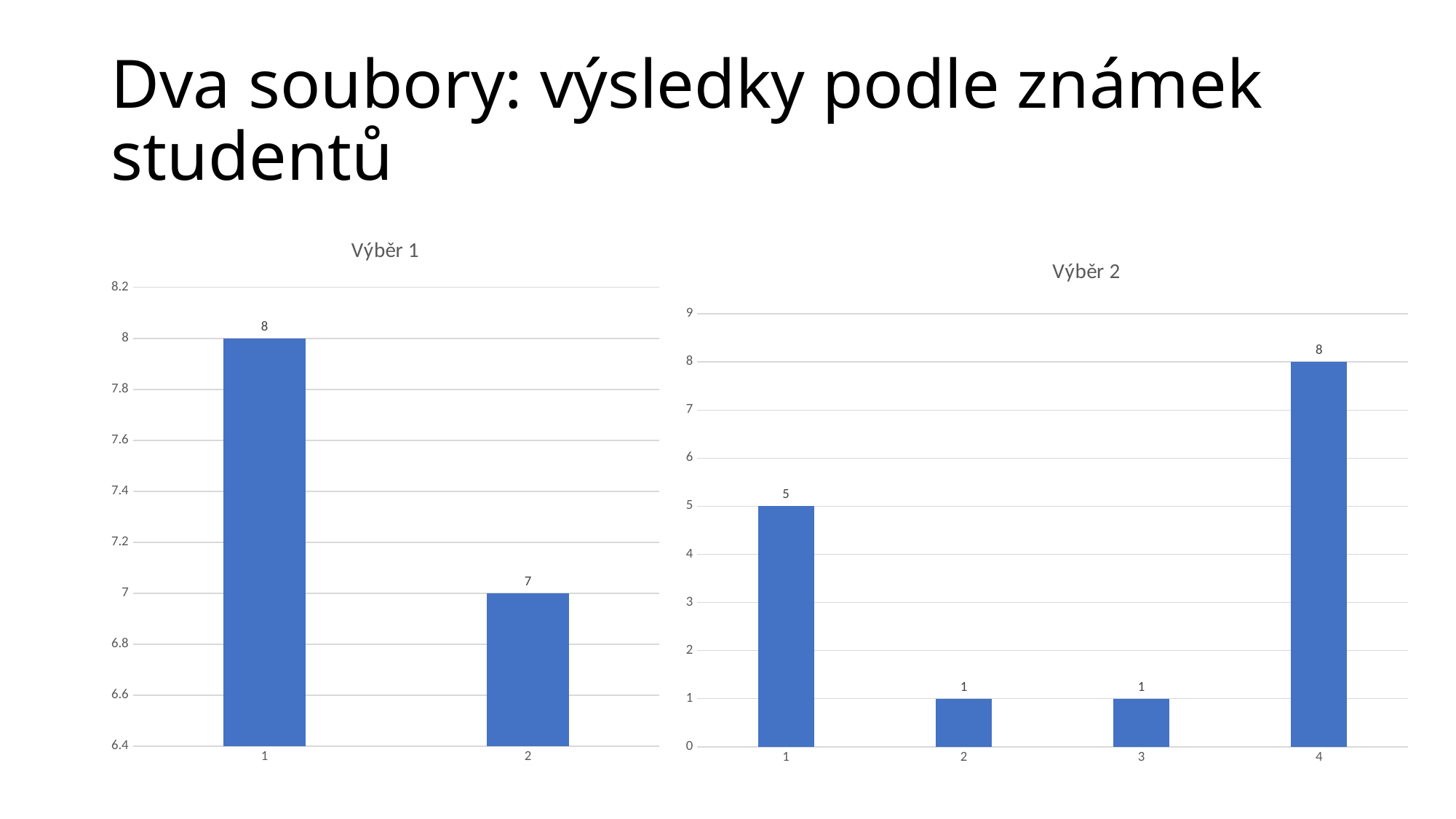
In the 'Výběr 2' chart, what is the value for category 1? 5 In the 'Výběr 1' chart, what kind of chart is shown? bar chart In the 'Výběr 2' chart, which is larger, the value for category 1 or the value for category 2? category 1 In the 'Výběr 2' chart, how many categories are plotted? 4 What is the title of the chart on the right side of the slide? Výběr 2 In the 'Výběr 2' chart, what is the difference between the values for category 4 and category 1? 3 In the 'Výběr 1' chart, how many categories are plotted? 2 In the 'Výběr 1' chart, what is the value for category 2? 7 In the 'Výběr 2' chart, what is the value for category 4? 8 In the 'Výběr 1' chart, what is the difference between the values for category 1 and category 2? 1 In the 'Výběr 1' chart, what is the value for category 1? 8 In the 'Výběr 2' chart, which category has the highest value? 4